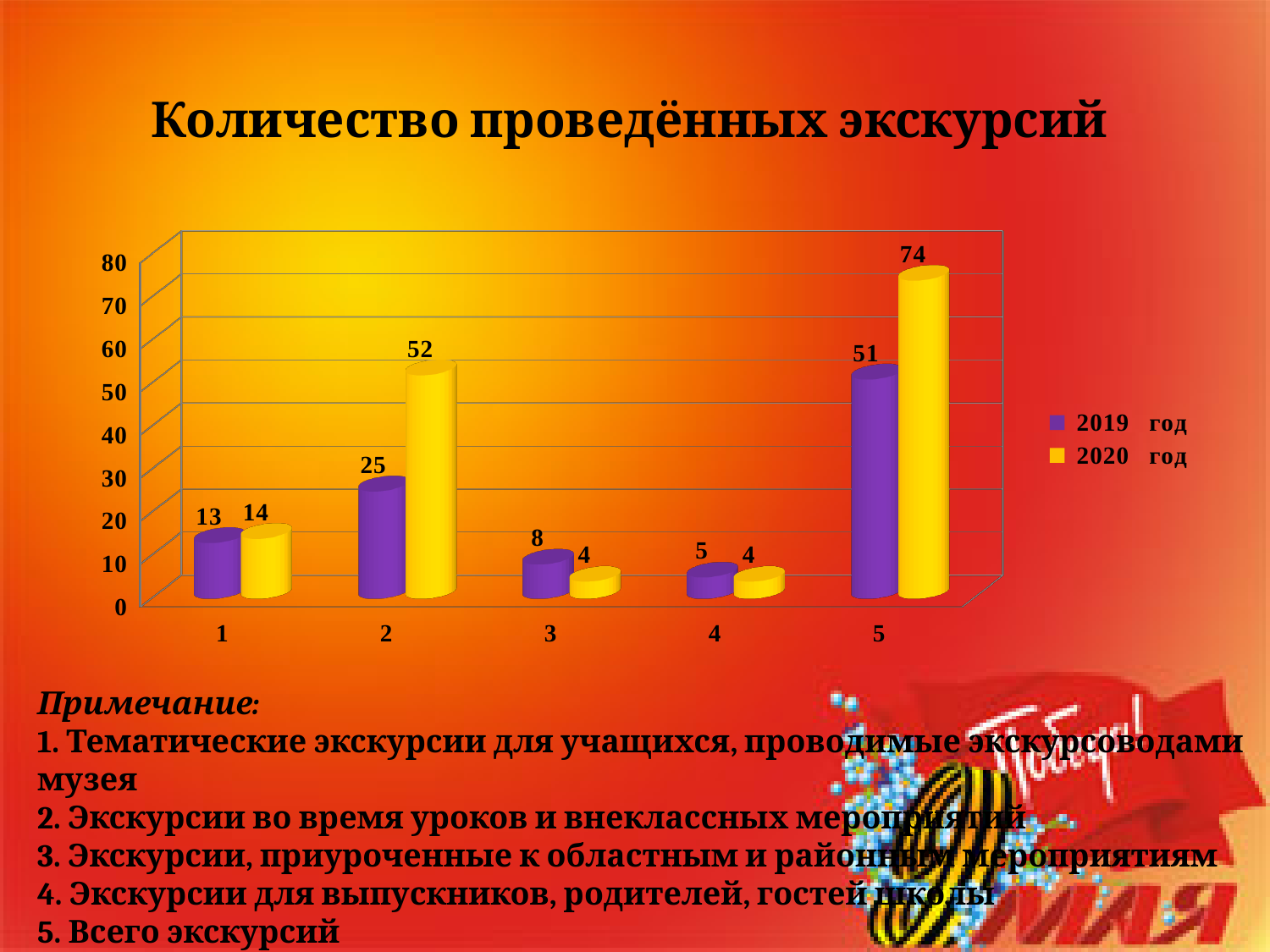
What kind of chart is shown on the slide? bar chart Which category has the lowest value in the 2019 год series? 4 What is the title of the chart? Количество проведённых экскурсий How many series does the legend list? 2 How many categories are shown on the x axis? 5 For category 3, which series has the larger value, 2019 год or 2020 год? 2019 год What is the difference between the 2020 год and 2019 год values for category 2? 27 What is the difference between the 2020 год and 2019 год values for category 5? 23 What is the value for category 5 in the 2019 год series? 51 What is the value for category 3 in the 2020 год series? 4 What is the value for category 2 in the 2020 год series? 52 Which category has the highest value in the 2020 год series? 5